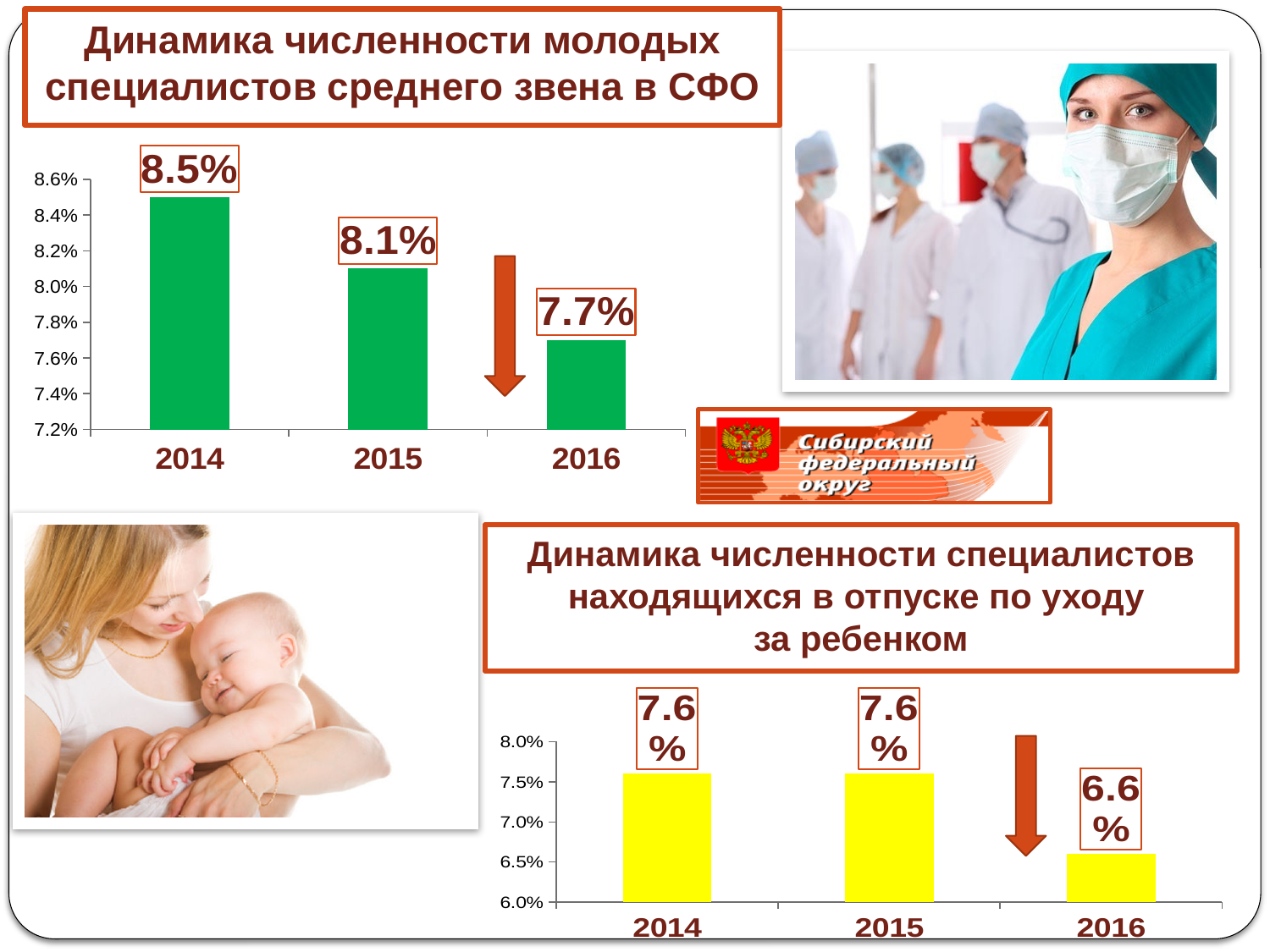
In the top chart (Динамика численности молодых специалистов среднего звена в СФО), what is the value for 2014? 8.5% In the top chart (Динамика численности молодых специалистов среднего звена в СФО), do the values rise or fall from 2014 to 2016? fall In the bottom chart (Динамика численности специалистов находящихся в отпуске по уходу за ребенком), which is larger, the value for 2014 or 2016? 2014 In the top chart (Динамика численности молодых специалистов среднего звена в СФО), which year has the lowest value? 2016 In the top chart (Динамика численности молодых специалистов среднего звена в СФО), how many years are shown? 3 In the bottom chart (Динамика численности специалистов находящихся в отпуске по уходу за ребенком), what is the difference between the 2015 and 2016 values? 1.0% What colour are the bars in the top chart (Динамика численности молодых специалистов среднего звена в СФО)? green In the top chart (Динамика численности молодых специалистов среднего звена в СФО), what is the difference between the 2014 and 2016 values? 0.8% In the top chart (Динамика численности молодых специалистов среднего звена в СФО), what is the value for 2016? 7.7% What type of chart is the bottom chart (Динамика численности специалистов находящихся в отпуске по уходу за ребенком)? bar chart In the bottom chart (Динамика численности специалистов находящихся в отпуске по уходу за ребенком), what is the value for 2015? 7.6% In the bottom chart (Динамика численности специалистов находящихся в отпуске по уходу за ребенком), what is the value for 2016? 6.6%